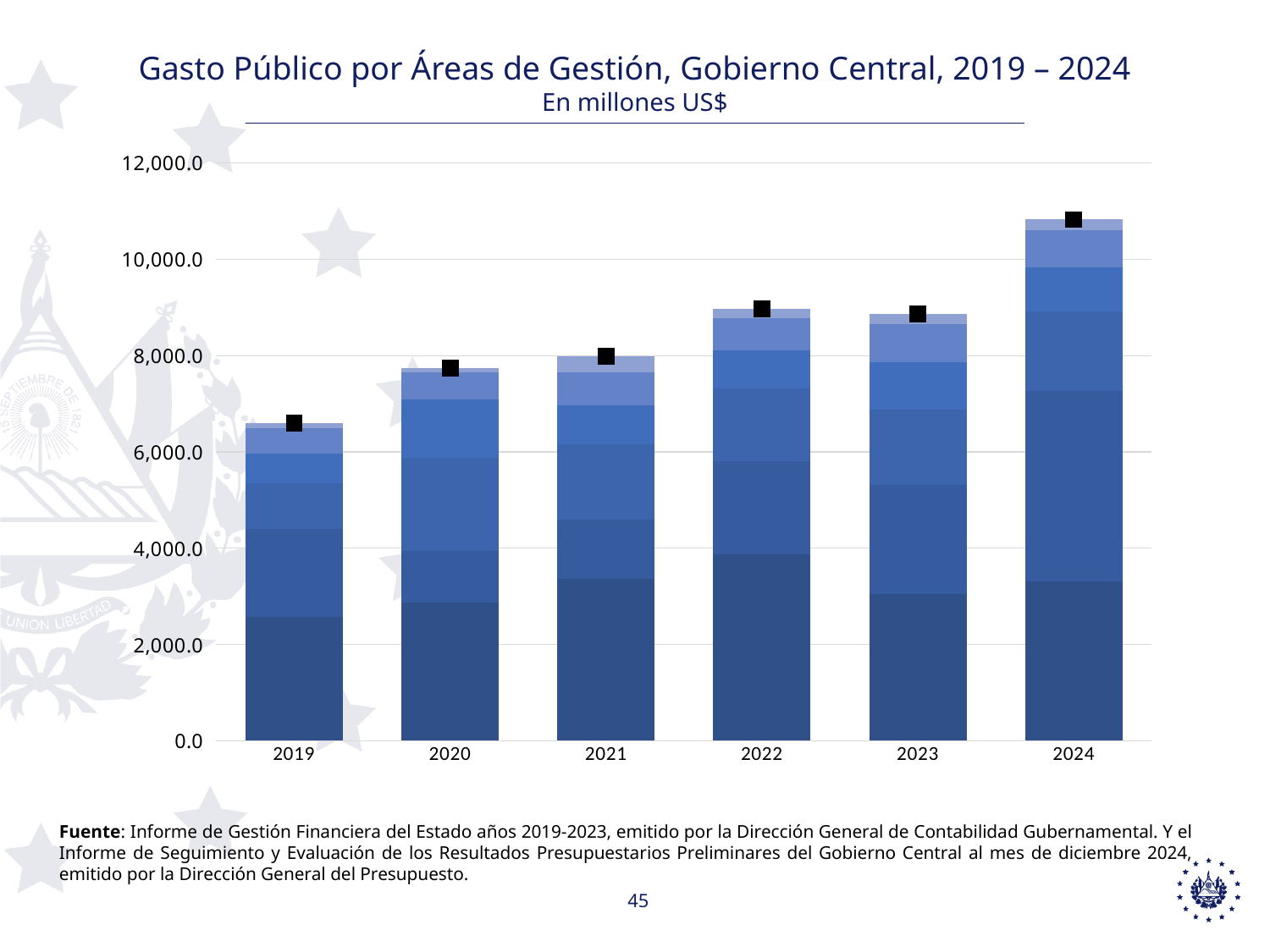
Which year has a larger total, 2019 or 2024? 2024 Which year has the highest total public spending in the chart? 2024 Which year has the lowest total public spending in the chart? 2019 Is the total for 2024 greater or less than 10,000.0? greater Is the total for 2019 greater or less than 6,000.0? greater Is the total for 2022 greater or less than 10,000.0? less Which year has a larger total, 2020 or 2021? 2021 How many years are shown on the x axis of the chart? 6 What kind of chart is shown on the slide? Stacked bar chart In what units are the values in the chart expressed, according to the subtitle? En millones US$ Do the total bar heights generally rise or fall from 2019 to 2024? rise